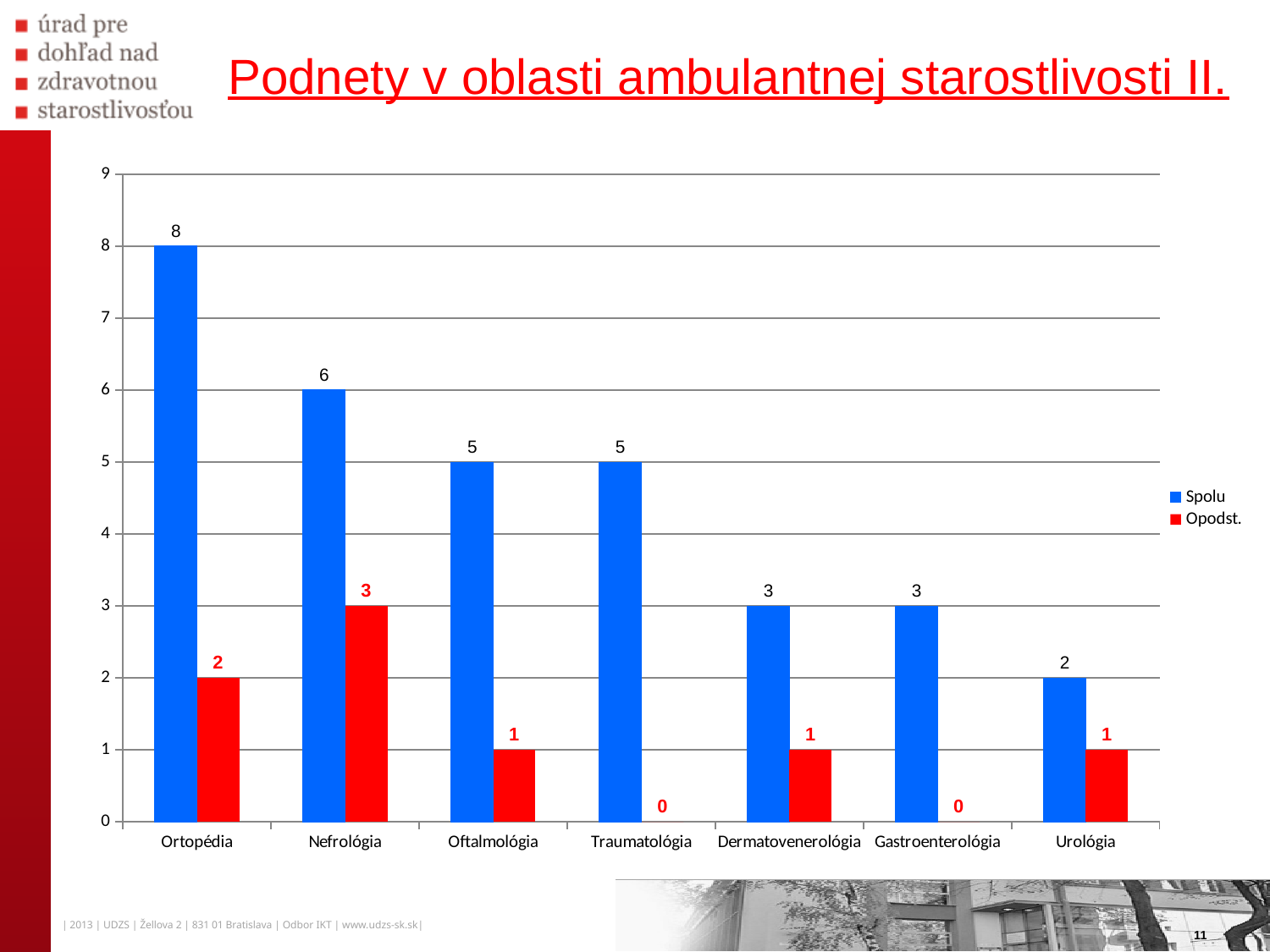
How many series does the legend list? 2 How many categories are shown on the x axis? 7 Which category has the highest Opodst. value? Nefrológia What is the Spolu value for Ortopédia? 8 What is the Opodst. value for Nefrológia? 3 What colour are the Opodst. bars? Red What is the Opodst. value for Traumatológia? 0 What is the difference between the Spolu and Opodst. values for Nefrológia? 3 What kind of chart is shown on the slide? Bar chart Which is larger, the Spolu value for Oftalmológia or the Spolu value for Urológia? Oftalmológia Which category has the lowest Spolu value? Urológia Which category has the highest Spolu value? Ortopédia